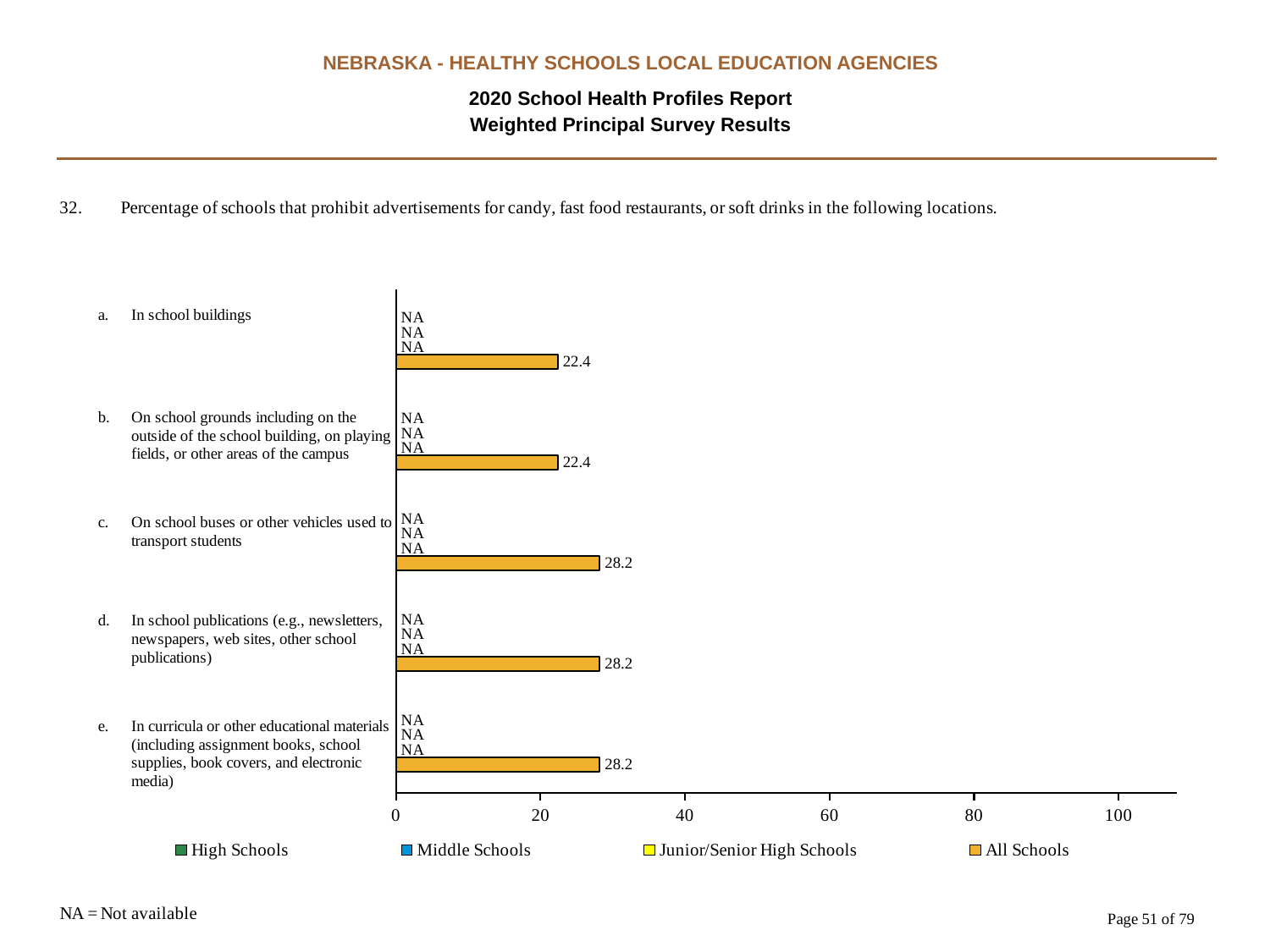
What value is shown for High Schools for 'In school buildings'? NA How many locations (categories) are listed in the chart? 5 Which is larger for All Schools: 'On school grounds including on the outside of the school building, on playing fields, or other areas of the campus' or 'In school publications'? In school publications What is the All Schools value for 'On school buses or other vehicles used to transport students'? 28.2 What kind of chart is shown on the slide? bar chart What is the All Schools value for 'In curricula or other educational materials'? 28.2 What is the difference between the All Schools values for 'On school buses or other vehicles used to transport students' and 'In school buildings'? 5.8 What does NA stand for according to the note on the slide? Not available How many series does the legend list? 4 Is the All Schools value for 'In school buildings' greater or less than 40? less What is the All Schools value for 'In school publications (e.g., newsletters, newspapers, web sites, other school publications)'? 28.2 What is the All Schools value for 'In school buildings'? 22.4